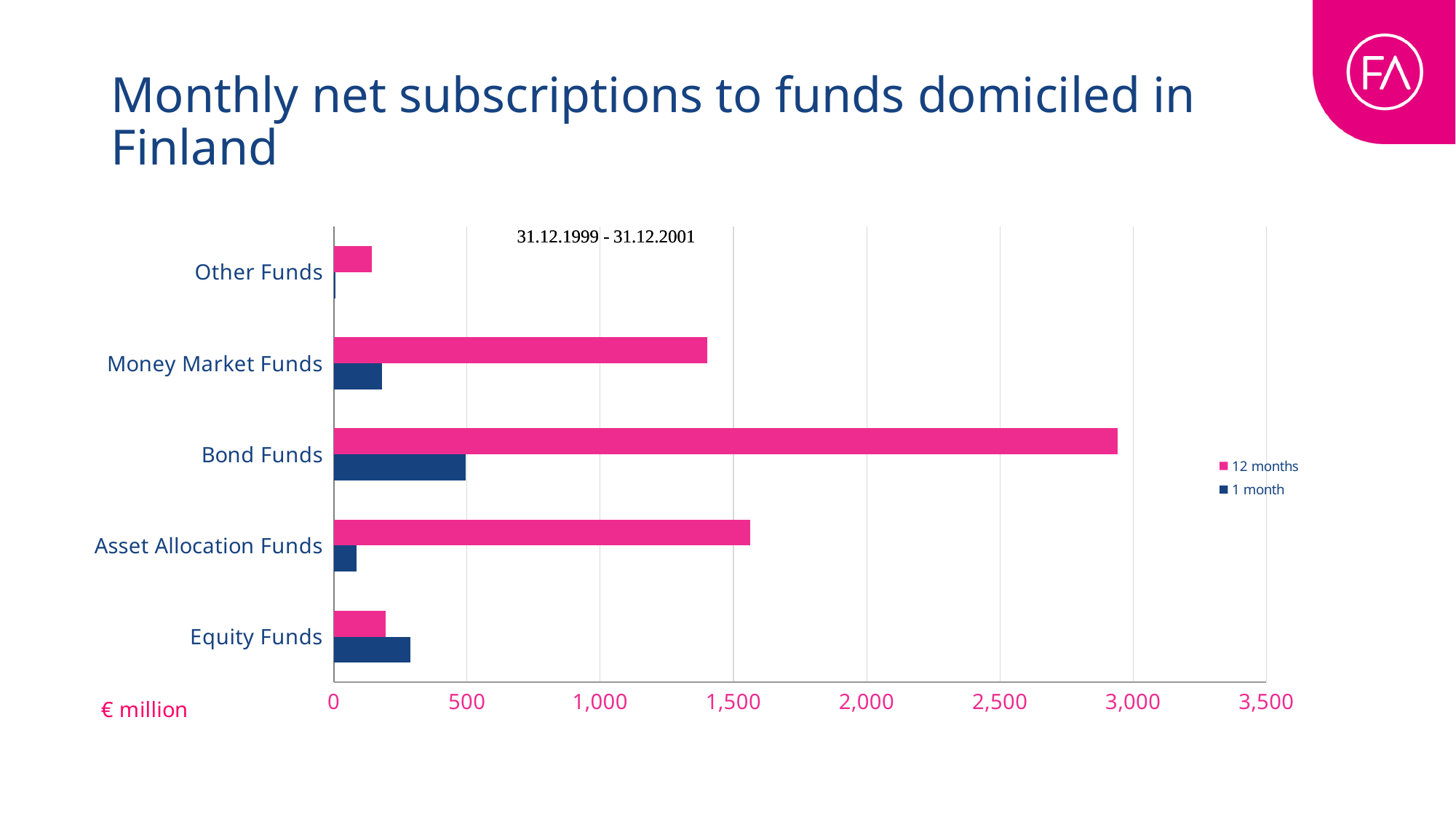
For Equity Funds, which is larger: the 12 months value or the 1 month value? 1 month Which fund category has the lowest 12 months value? Other Funds Is the 12 months value for Bond Funds greater or less than 2,500? greater Is the 12 months value for Money Market Funds greater or less than 1,500? less Which is larger: the 12 months value for Asset Allocation Funds or the 12 months value for Money Market Funds? Asset Allocation Funds What kind of chart is shown on the slide? bar chart Which fund category has the highest 12 months value? Bond Funds What unit is shown for the horizontal axis of the chart? € million Which fund category has the lowest 1 month value? Other Funds Which fund category has the highest 1 month value? Bond Funds How many series does the legend list? 2 How many fund categories are shown on the chart? 5